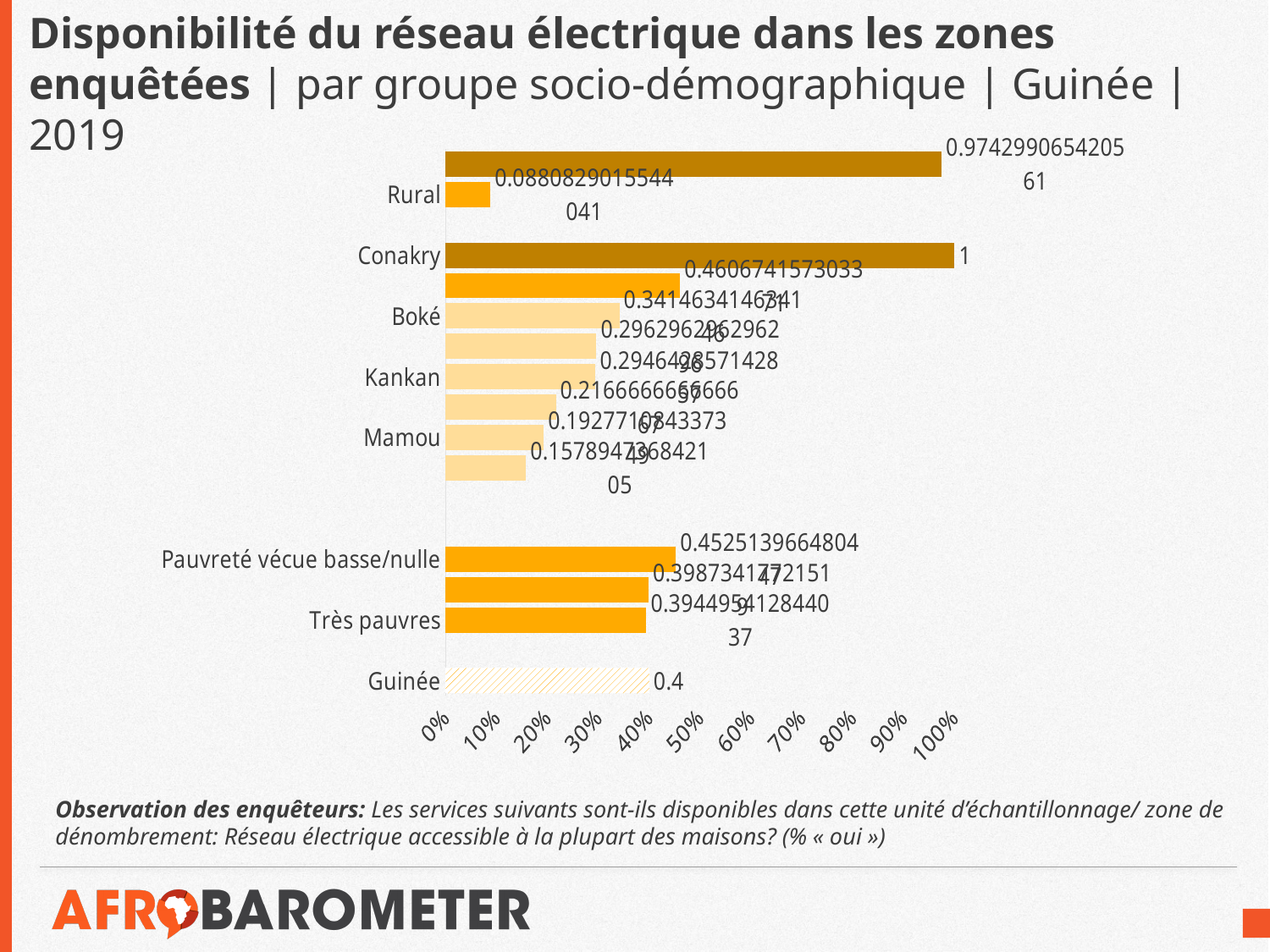
Which category has the highest value? Conakry Which is larger, the value for Boké or the value for Kankan? Boké What is the value shown for Conakry? 1 What kind of chart is shown on the slide? bar chart Is the value for Rural greater or less than 20%? less Which category has the lowest value? Rural Is the value for Très pauvres greater or less than 30%? greater Is the value for Conakry greater or less than 90%? greater What is the value shown for Guinée? 0.4 What is the difference between the value for Conakry and the value for Guinée? 0.6 Which is larger, the value for Pauvreté vécue basse/nulle or the value for Très pauvres? Pauvreté vécue basse/nulle